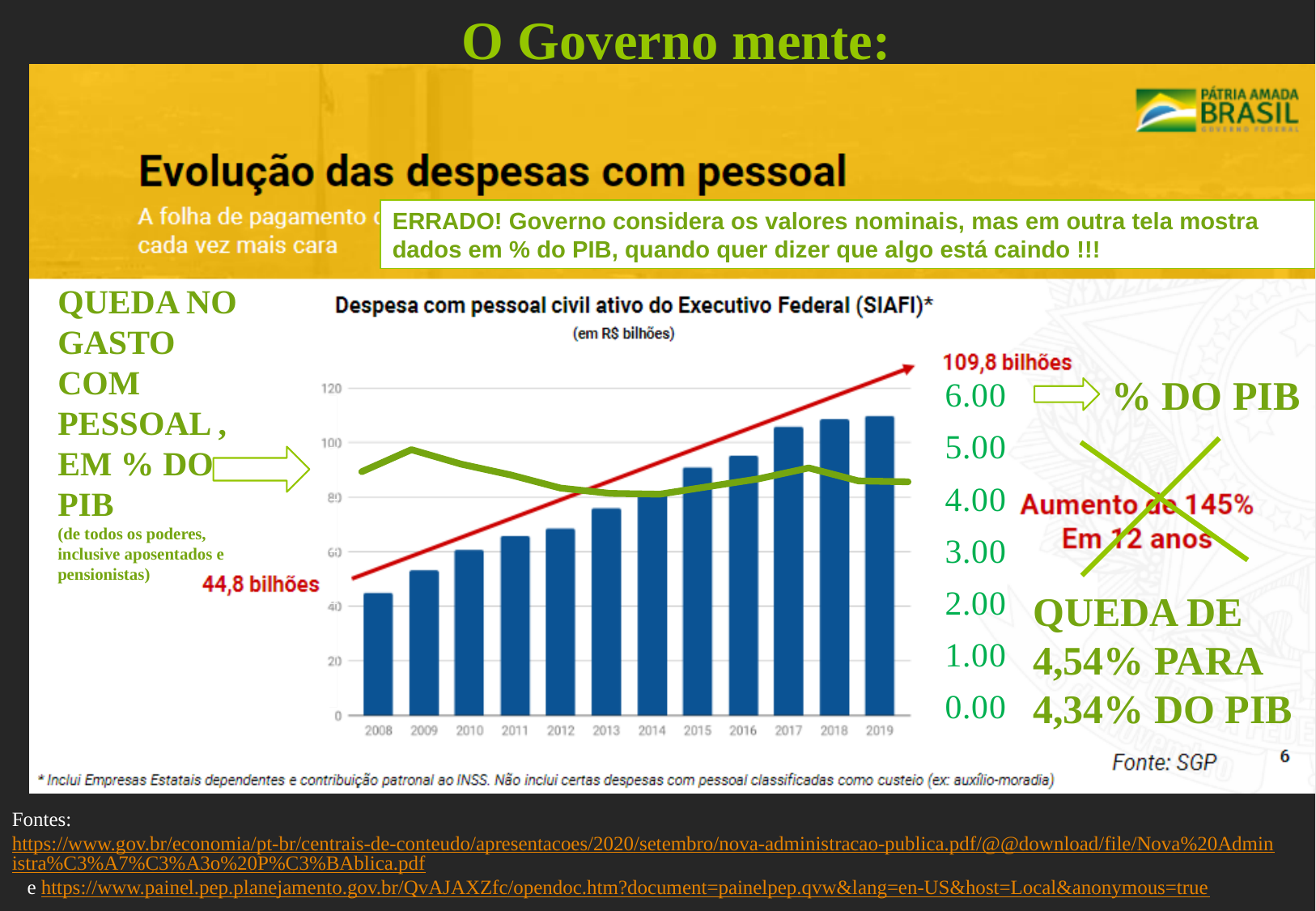
Do the bars in the Despesa com pessoal civil ativo chart rise or fall from 2008 to 2019? rise What is the difference between the labelled values for 2019 and 2008 in the Despesa com pessoal civil ativo chart? 65 bilhões What value is labelled for 2008 in the Despesa com pessoal civil ativo chart? 44,8 bilhões In the Despesa com pessoal civil ativo chart, is the bar for 2017 greater or less than 100? greater What kind of chart is used to show the Despesa com pessoal civil ativo do Executivo Federal? bar chart What value is labelled for 2019 in the Despesa com pessoal civil ativo chart? 109,8 bilhões In the Despesa com pessoal civil ativo chart, is the bar for 2014 greater or less than 100? less Which year has the lowest bar in the Despesa com pessoal civil ativo chart? 2008 Which year has the highest bar in the Despesa com pessoal civil ativo chart? 2019 How many years (bars) are shown in the Despesa com pessoal civil ativo chart? 12 In what unit are the values of the Despesa com pessoal civil ativo chart expressed, according to its subtitle? em R$ bilhões In the Despesa com pessoal civil ativo chart, which bar is taller, 2013 or 2017? 2017